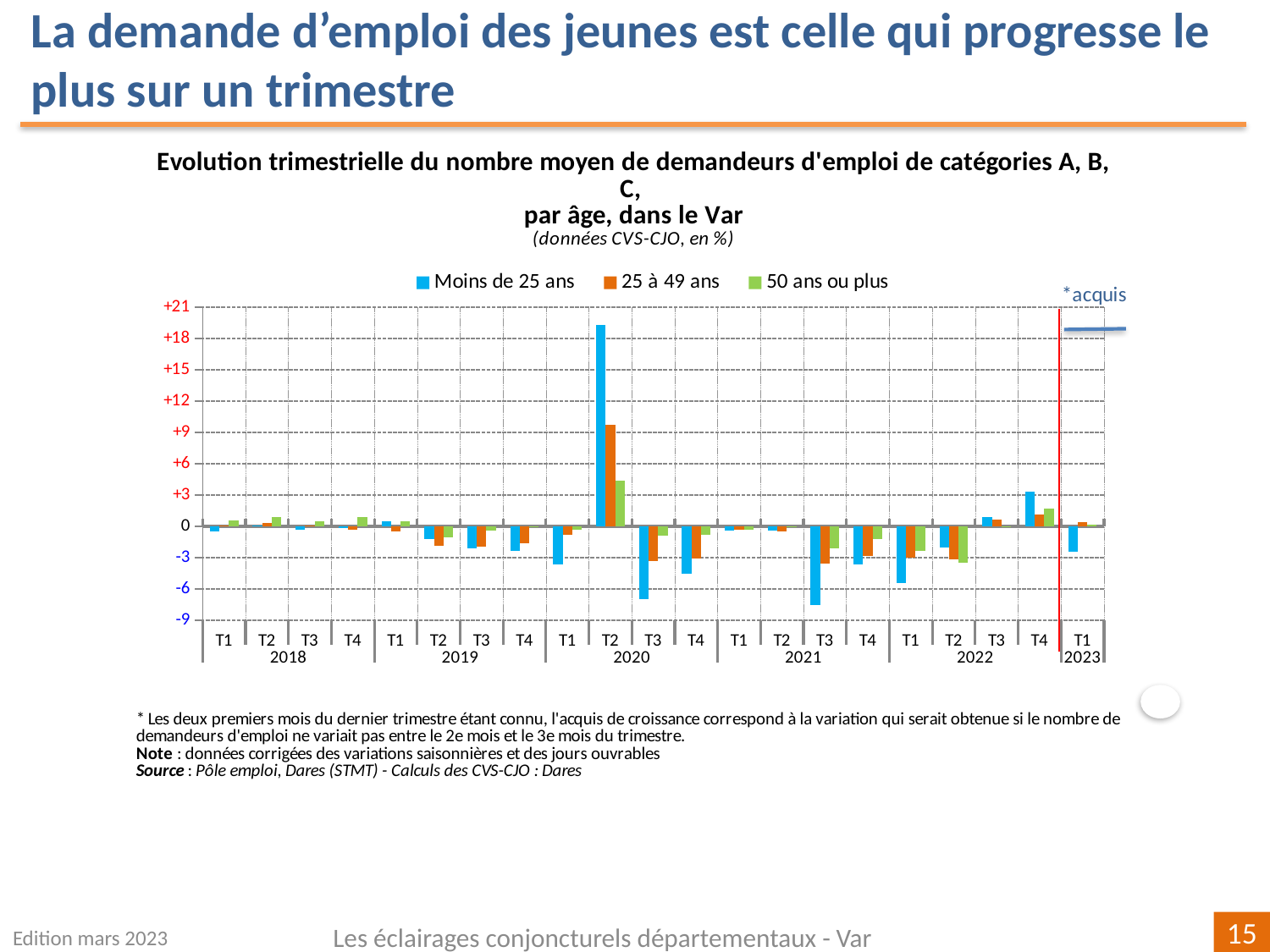
How many series does the legend list? 3 What kind of chart is shown on the slide? bar chart Is the value for Moins de 25 ans in T3 2021 greater or less than -6? less Is the value for 25 à 49 ans in T2 2020 greater or less than 6? greater Is the value for Moins de 25 ans in T2 2020 greater or less than 15? greater How many quarters are shown on the x axis? 21 Which series is shown in orange in the legend? 25 à 49 ans In T4 2022, which is larger: the value for Moins de 25 ans or the value for 50 ans ou plus? Moins de 25 ans Which series has the lowest value in T3 2021? Moins de 25 ans Which series has the highest value in T2 2020? Moins de 25 ans